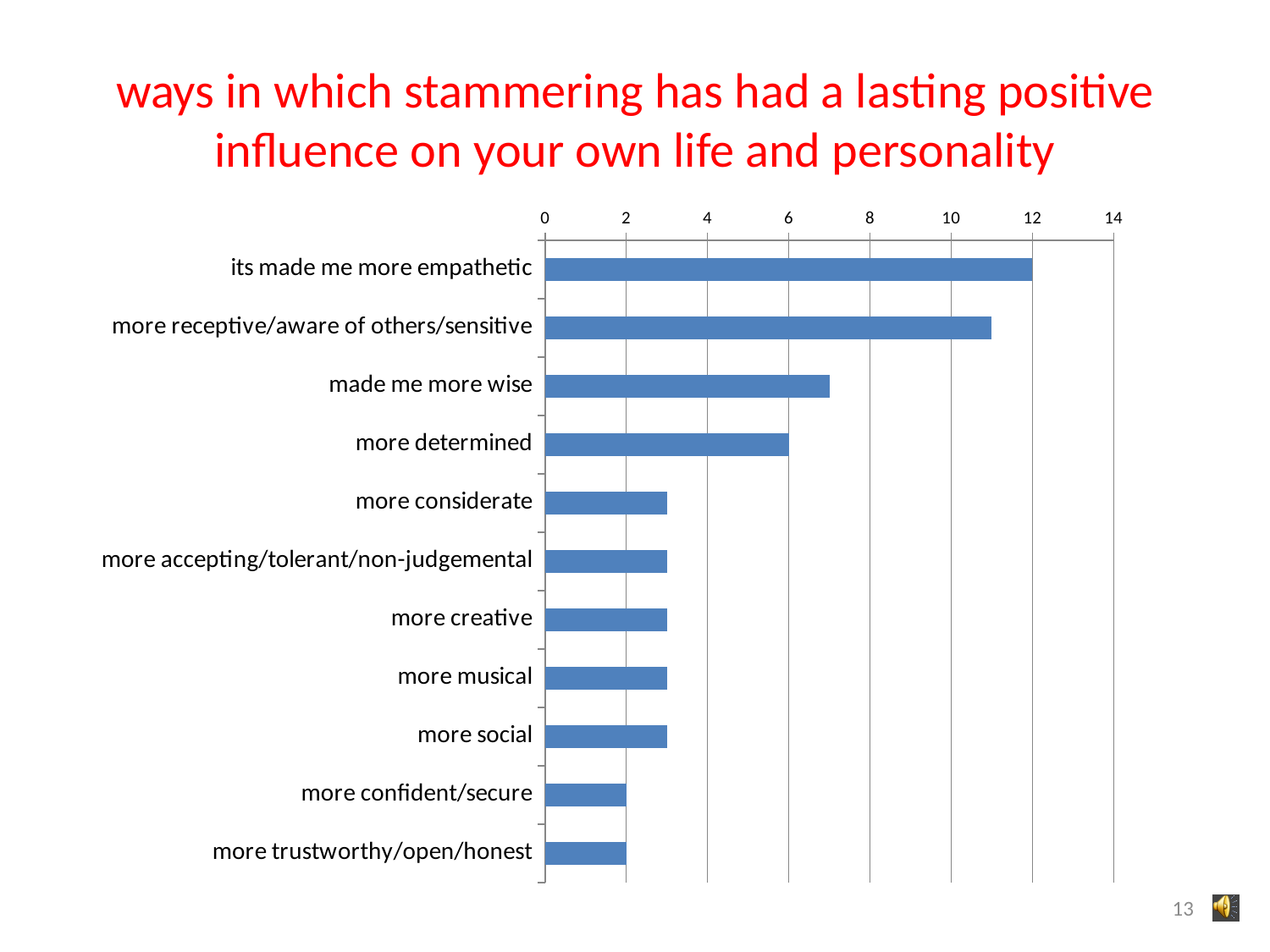
How many categories are plotted in the chart? 11 What is the value for 'more trustworthy/open/honest'? 2 Is the value for 'more receptive/aware of others/sensitive' greater or less than 10? greater What is the value for 'more confident/secure'? 2 Which is larger, the value for 'made me more wise' or the value for 'more determined'? made me more wise Which category has the highest value? its made me more empathetic Is the value for 'made me more wise' greater or less than 8? less What is the value for 'more determined'? 6 What kind of chart is shown on the slide? bar chart What is the difference between the values for 'its made me more empathetic' and 'more determined'? 6 What is the value for 'its made me more empathetic'? 12 Is the value for 'more considerate' greater or less than 4? less